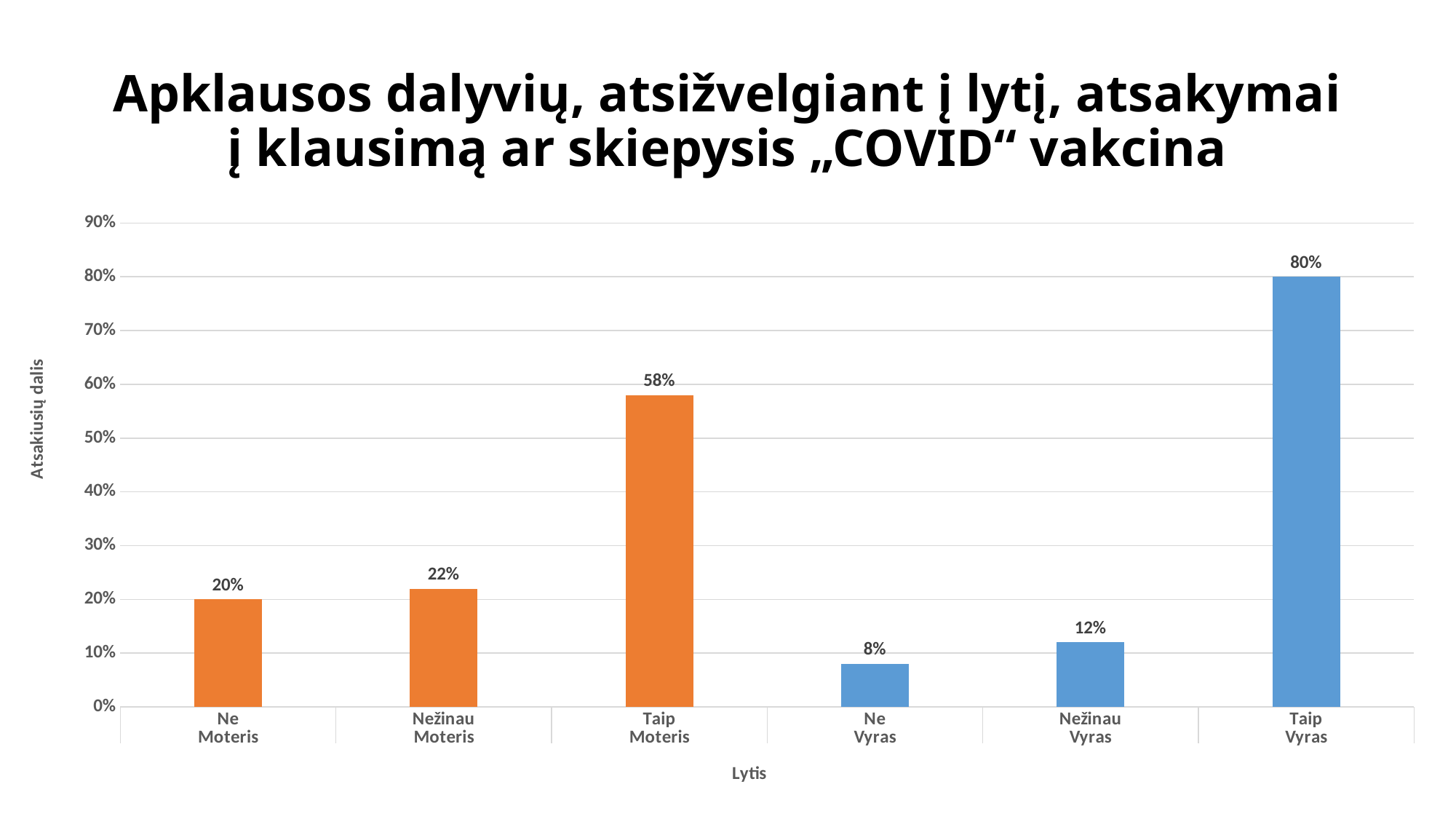
What is the difference between the values for Taip Vyras and Taip Moteris? 22% Which category has the highest value? Taip Vyras How many categories are shown on the x axis? 6 What is the value for Ne Vyras? 8% What colour are the bars for the Vyras categories? blue Which is larger, the value for Ne Moteris or the value for Nežinau Vyras? Ne Moteris Is the value for Taip Moteris greater or less than 50%? greater What is the value for Taip Moteris? 58% What is the value for Nežinau Moteris? 22% What is the label of the x axis? Lytis What kind of chart is shown on the slide? bar chart Which category has the lowest value? Ne Vyras